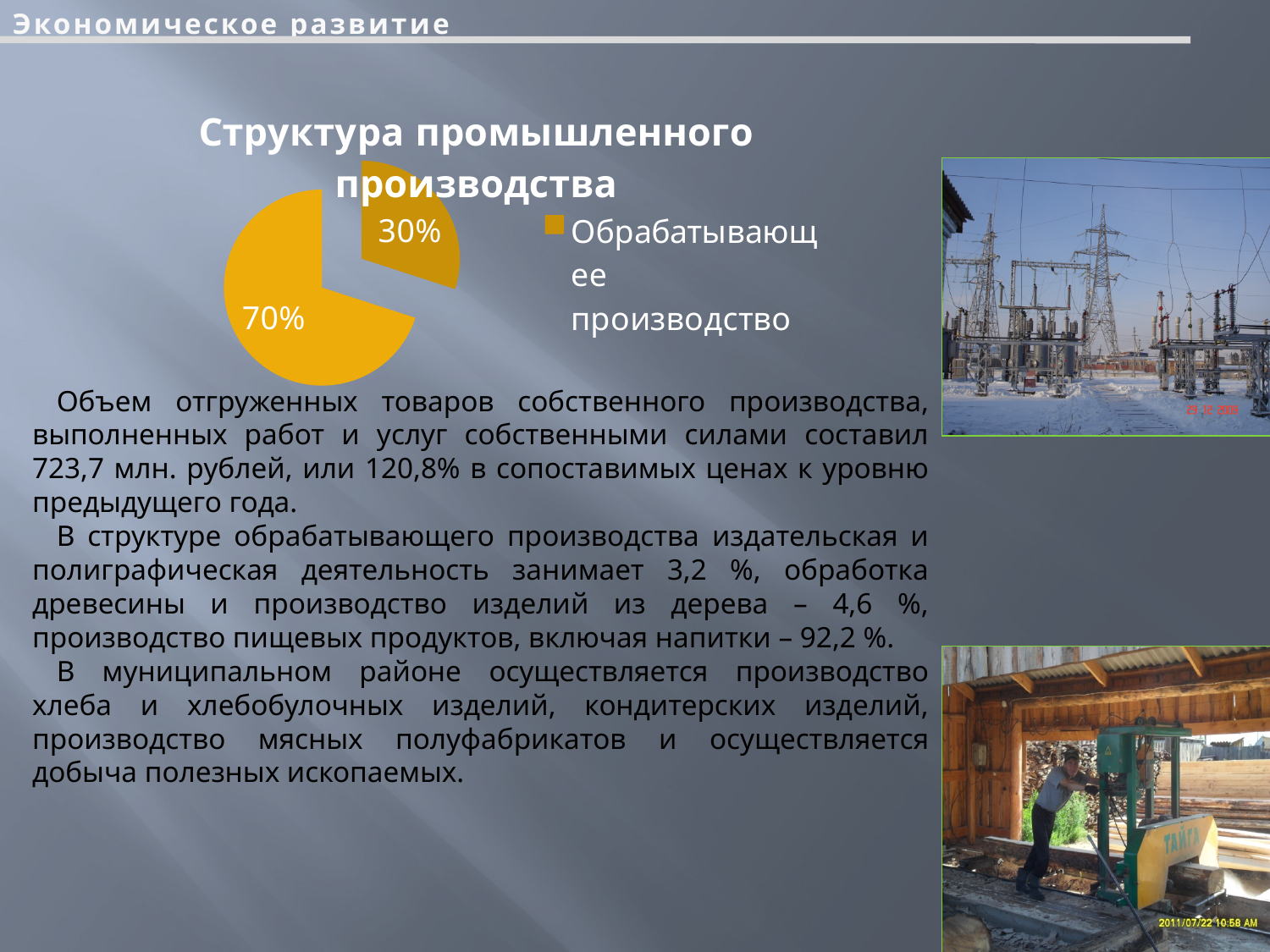
Which legend entry is readable next to the pie chart? Обрабатывающее производство How many slices does the pie chart have? 2 What is the value of the smallest slice in the pie chart? 30% What is the value of the largest slice in the pie chart? 70% Which slice of the pie chart is larger, the one labelled 70% or the one labelled 30%? 70% Do the two slices of the pie chart add up to 100%? yes What kind of chart is shown on the slide? pie chart What is the title of the chart on the slide? Структура промышленного производства What share of the pie does the smaller, separated slice represent? 30% What share of the pie does the larger slice represent? 70% What is the difference between the two slices of the pie chart, in percentage points? 40